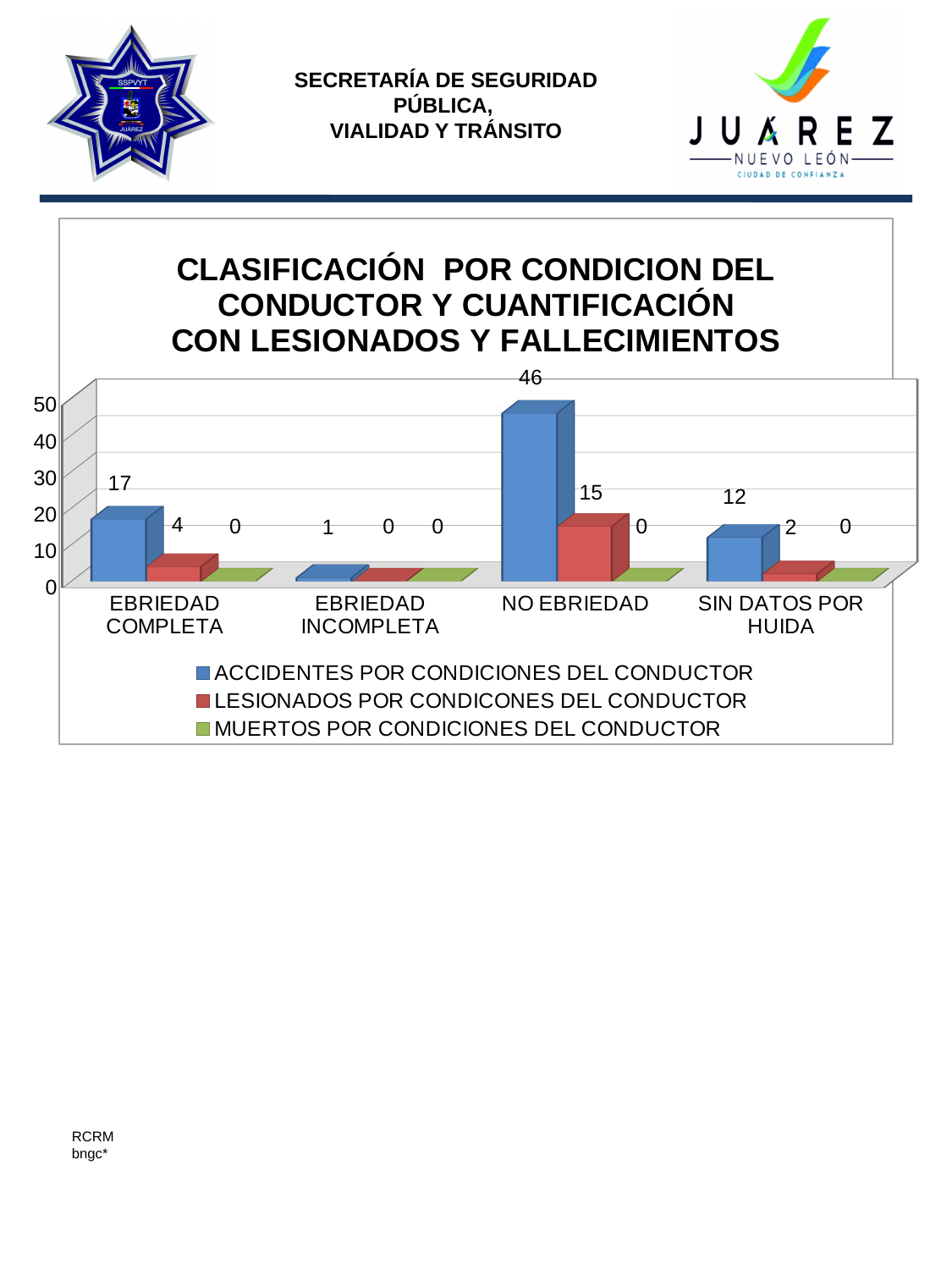
Which is larger: LESIONADOS POR CONDICONES DEL CONDUCTOR for NO EBRIEDAD or for SIN DATOS POR HUIDA? NO EBRIEDAD What is the value for ACCIDENTES POR CONDICIONES DEL CONDUCTOR in the SIN DATOS POR HUIDA category? 12 How many series does the legend list? 3 What is the value for LESIONADOS POR CONDICONES DEL CONDUCTOR in the EBRIEDAD COMPLETA category? 4 How many categories are shown on the x axis? 4 What is the value for MUERTOS POR CONDICIONES DEL CONDUCTOR in the NO EBRIEDAD category? 0 Which category has the highest value for ACCIDENTES POR CONDICIONES DEL CONDUCTOR? NO EBRIEDAD Which category has the lowest value for ACCIDENTES POR CONDICIONES DEL CONDUCTOR? EBRIEDAD INCOMPLETA What colour represents MUERTOS POR CONDICIONES DEL CONDUCTOR in the legend? Green What is the difference between the ACCIDENTES POR CONDICIONES DEL CONDUCTOR values for NO EBRIEDAD and EBRIEDAD COMPLETA? 29 What is the value for ACCIDENTES POR CONDICIONES DEL CONDUCTOR in the NO EBRIEDAD category? 46 What kind of chart is shown on the slide? Bar chart